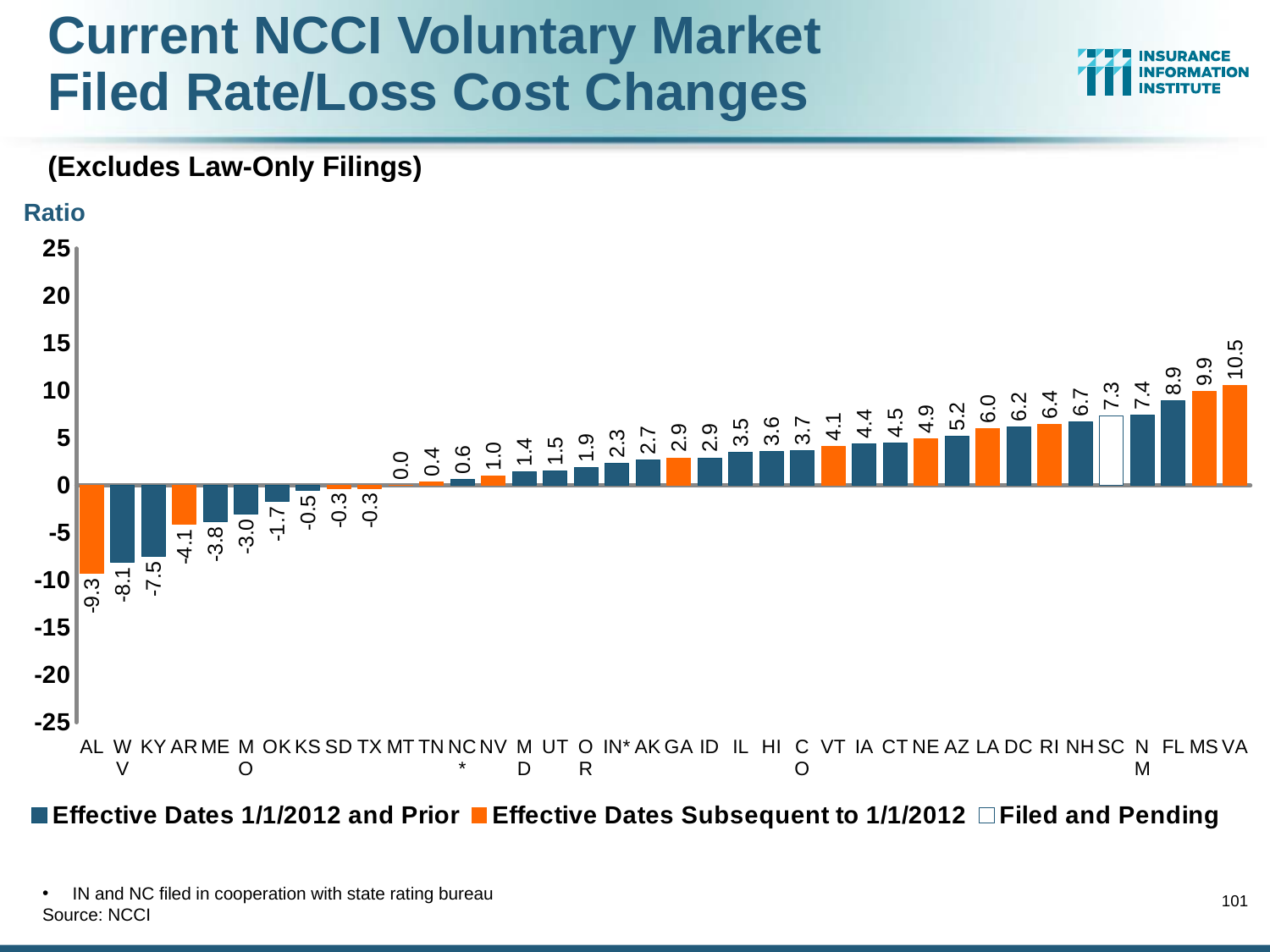
What is the value for VA? 10.5 Which state has the lowest value? AL How many series does the legend list? 3 What is the value for AL? -9.3 Is the value for KY greater or less than -5? less What kind of chart is shown? bar chart Which state has the highest value? VA Which state's bar is in the 'Filed and Pending' series? SC How many states are shown on the x axis? 38 What is the difference between the values for VA and AL? 19.8 Which is larger, the value for MS or the value for FL? MS What is the value for SC? 7.3